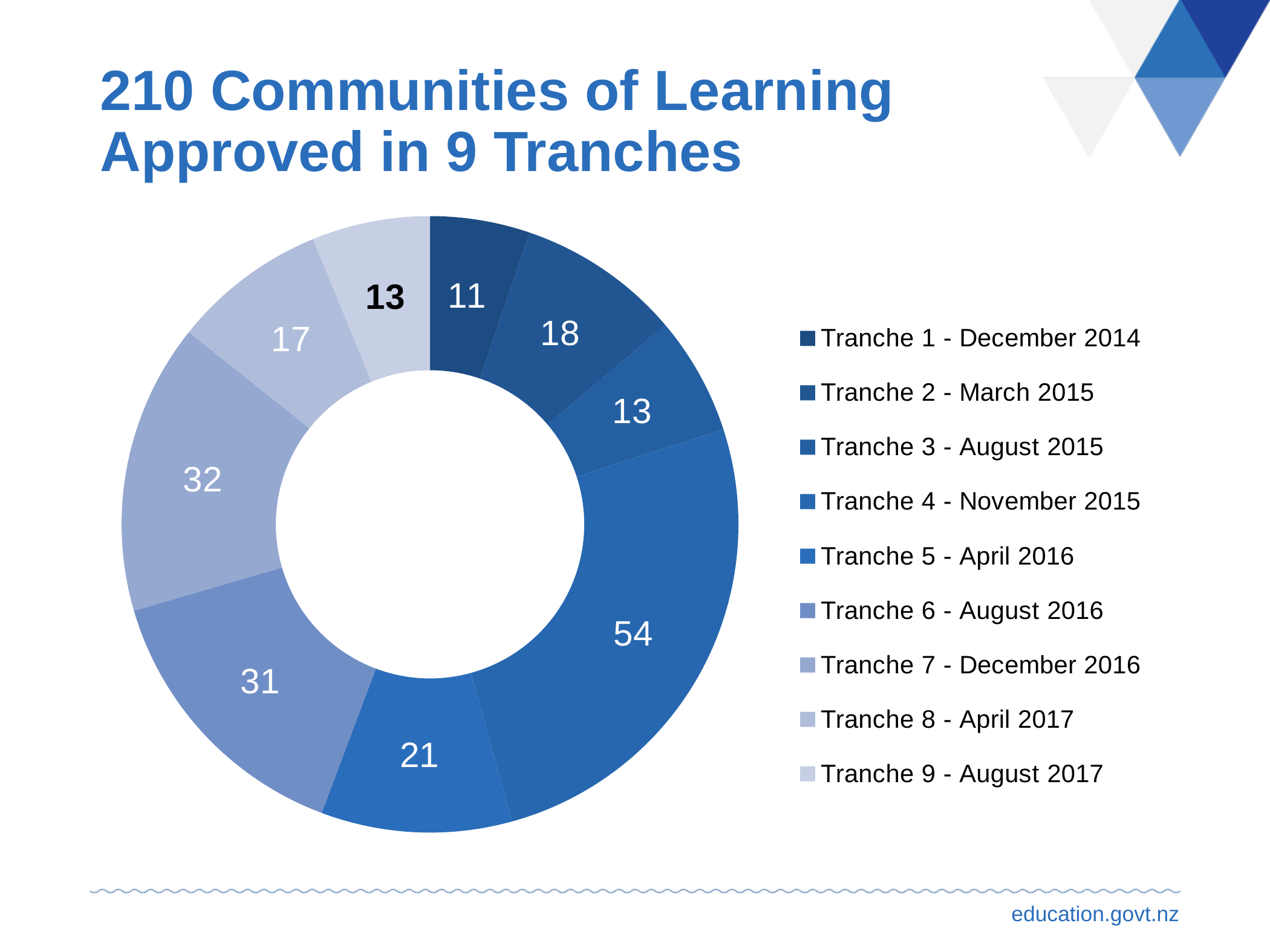
How many tranches (slices) does the chart show? 9 Which is larger, the value for Tranche 2 - March 2015 or Tranche 8 - April 2017? Tranche 2 - March 2015 Which tranche has the smallest number of Communities of Learning approved? Tranche 1 - December 2014 What is the title of the slide containing the chart? 210 Communities of Learning Approved in 9 Tranches What is the value for Tranche 1 - December 2014? 11 What is the value for Tranche 9 - August 2017? 13 How many Communities of Learning were approved in Tranche 4 - November 2015? 54 What is the value for Tranche 7 - December 2016? 32 How many entries does the legend list? 9 What is the difference between the values for Tranche 4 - November 2015 and Tranche 5 - April 2016? 33 What kind of chart is shown on the slide? Pie chart (doughnut) Which tranche has the largest number of Communities of Learning approved? Tranche 4 - November 2015